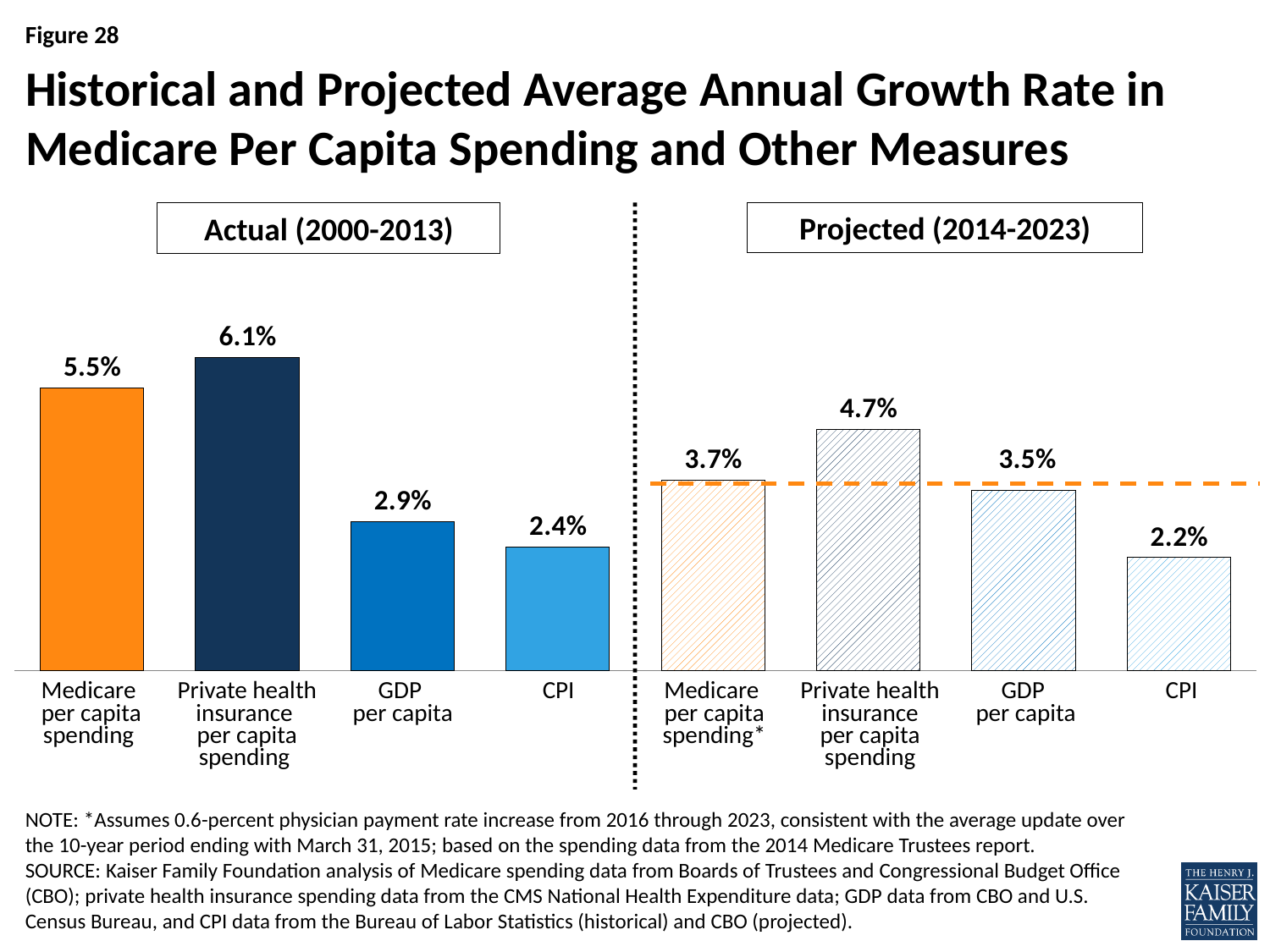
What is the projected (2014-2023) average annual growth rate for private health insurance per capita spending? 4.7% Which is larger: the actual (2000-2013) growth rate for CPI or the projected (2014-2023) growth rate for CPI? Actual (2000-2013) CPI What is the actual (2000-2013) growth rate for GDP per capita? 2.9% What is the actual (2000-2013) average annual growth rate for Medicare per capita spending? 5.5% Do the values fall from left to right within the Projected (2014-2023) group after private health insurance per capita spending? Yes, they fall How many measures are shown in the Projected (2014-2023) group? 4 Which measure has the highest actual (2000-2013) growth rate? Private health insurance per capita spending What is the difference between the actual (2000-2013) and projected (2014-2023) growth rates for Medicare per capita spending? 1.8% What kind of chart is shown on the slide? Bar chart Which measure has the lowest projected (2014-2023) growth rate? CPI What is the difference between the projected growth rates for private health insurance per capita spending and GDP per capita? 1.2% What is the projected (2014-2023) growth rate for CPI? 2.2%